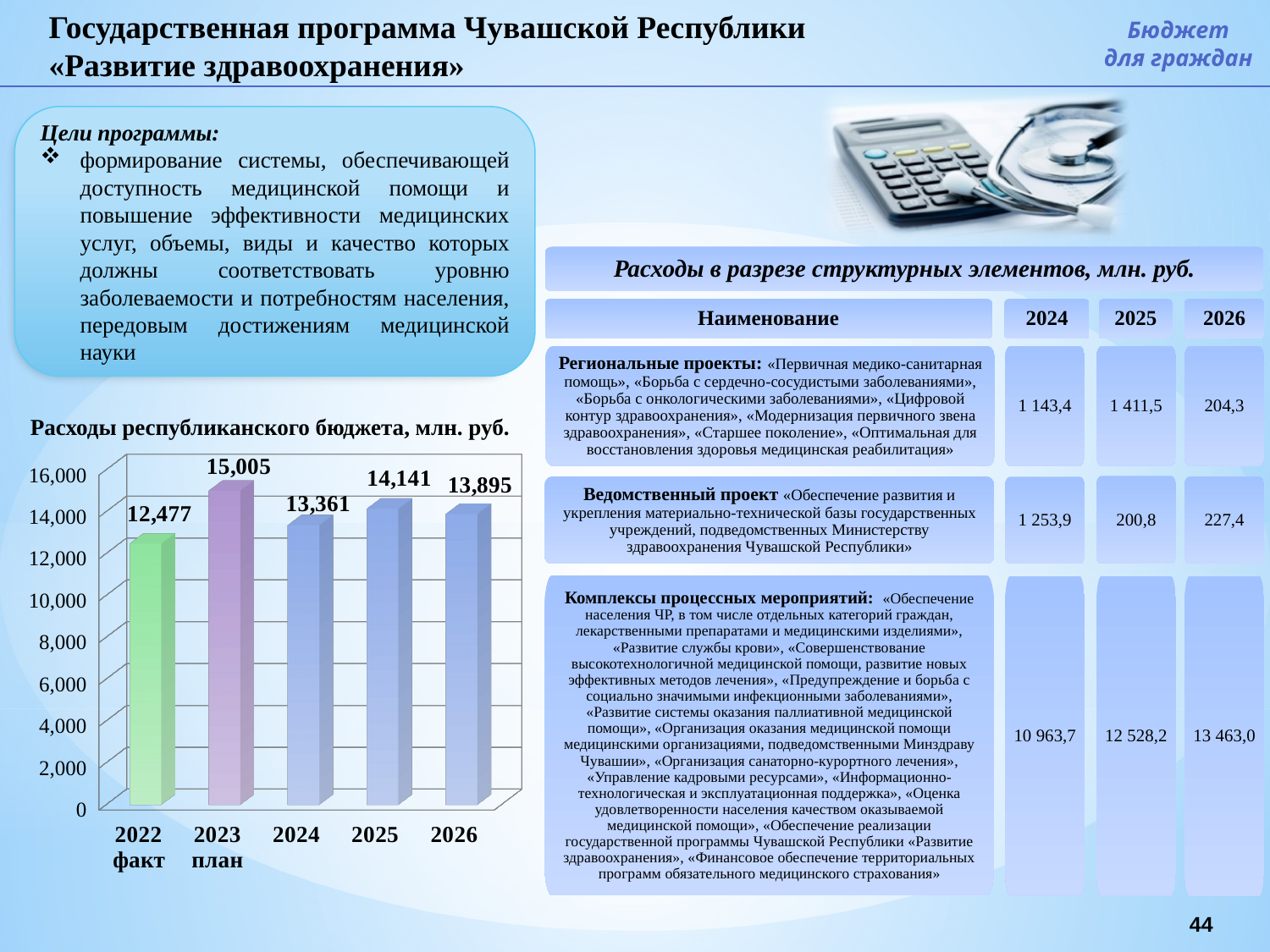
Which year has the highest value in the chart 'Расходы республиканского бюджета, млн. руб.'? 2023 план What is the value for 2023 план in the chart 'Расходы республиканского бюджета, млн. руб.'? 15,005 What is the value for 2025 in the chart 'Расходы республиканского бюджета, млн. руб.'? 14,141 What is the value for 2022 факт in the chart 'Расходы республиканского бюджета, млн. руб.'? 12,477 What kind of chart is 'Расходы республиканского бюджета, млн. руб.'? bar chart How many bars are shown in the chart 'Расходы республиканского бюджета, млн. руб.'? 5 In the chart 'Расходы республиканского бюджета, млн. руб.', what is the difference between the 2025 value and the 2024 value? 780 In the chart 'Расходы республиканского бюджета, млн. руб.', what is the difference between the 2023 план value and the 2022 факт value? 2,528 Which year has the lowest value in the chart 'Расходы республиканского бюджета, млн. руб.'? 2022 факт In the chart 'Расходы республиканского бюджета, млн. руб.', which is larger: the value for 2024 or the value for 2026? 2026 What is the value for 2026 in the chart 'Расходы республиканского бюджета, млн. руб.'? 13,895 In the chart 'Расходы республиканского бюджета, млн. руб.', is the value for 2022 факт greater or less than 12,000? greater